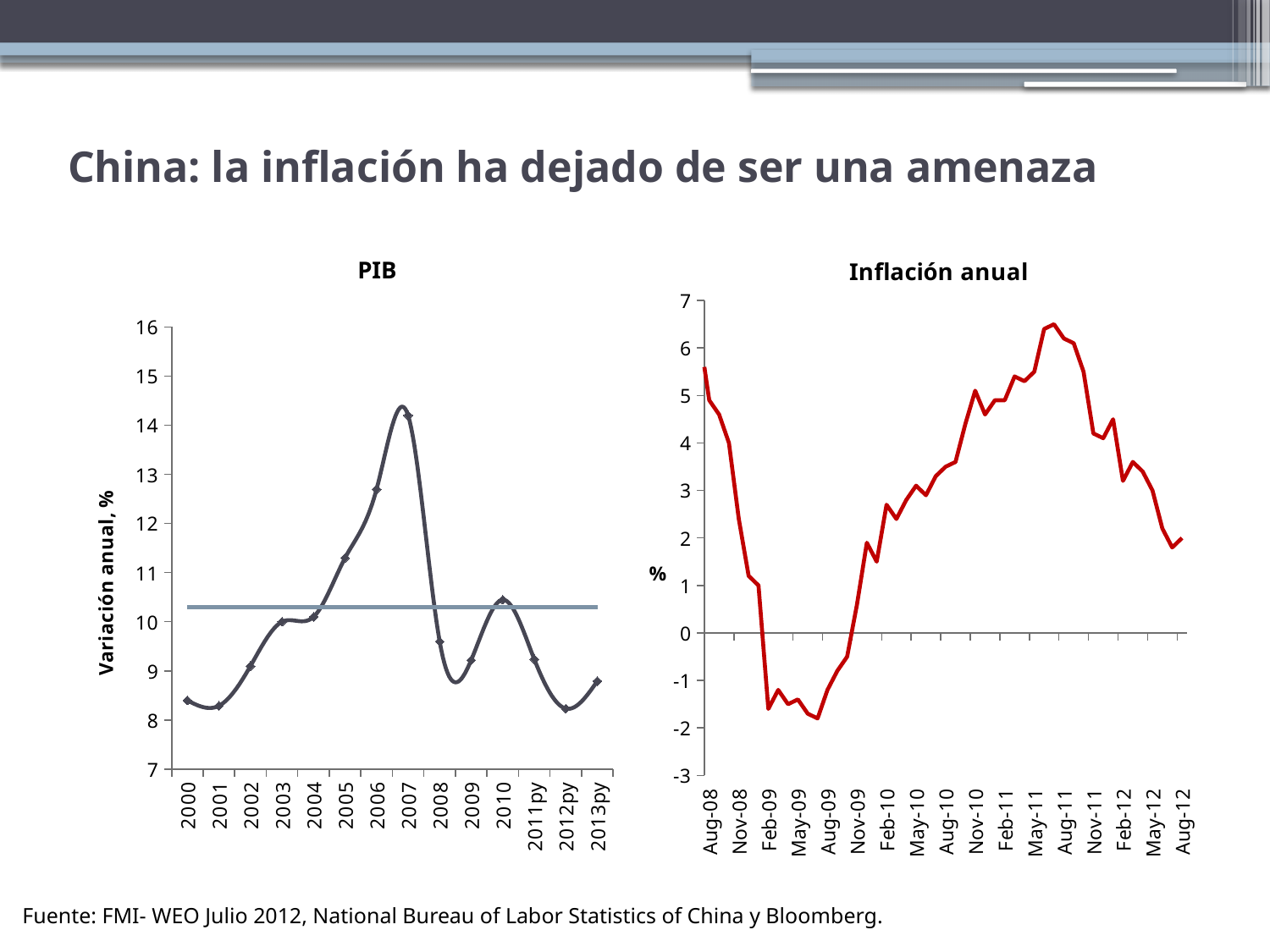
In the PIB chart, is the value for 2000 greater or less than 9? less In the PIB chart, how many years are shown on the x axis? 14 In the PIB chart, which is larger, the value for 2006 or the value for 2008? 2006 In the Inflación anual chart, do the values rise or fall between Aug-11 and Aug-12? fall In the Inflación anual chart, is the value for Aug-12 greater or less than 3? less What kind of chart is the PIB chart? line chart What kind of chart is the Inflación anual chart? line chart In the PIB chart, what is the label of the vertical axis? Variación anual, % In the PIB chart, is the value for 2007 greater or less than 13? greater In the PIB chart, which year has the highest value? 2007